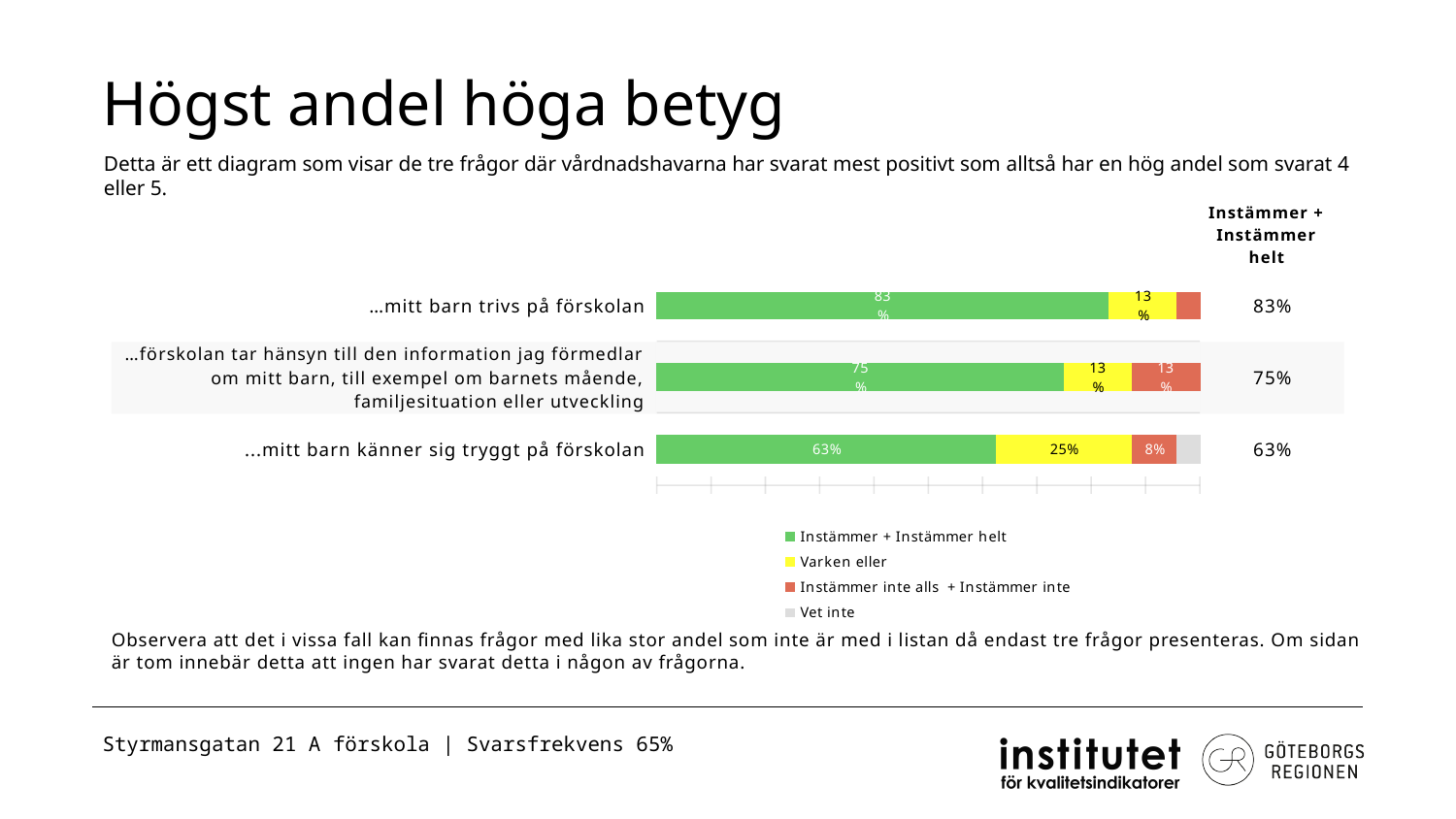
What is the 'Varken eller' value for '…mitt barn känner sig tryggt på förskolan'? 25% Which colour represents 'Vet inte' in the legend? grey What is the 'Instämmer inte alls + Instämmer inte' value for '…förskolan tar hänsyn till den information jag förmedlar om mitt barn, till exempel om barnets mående, familjesituation eller utveckling'? 13% Which has a larger 'Varken eller' share: '…mitt barn trivs på förskolan' or '…mitt barn känner sig tryggt på förskolan'? …mitt barn känner sig tryggt på förskolan What is the 'Instämmer inte alls + Instämmer inte' value for '…mitt barn känner sig tryggt på förskolan'? 8% Which question has the lowest 'Instämmer + Instämmer helt' share? …mitt barn känner sig tryggt på förskolan What is the difference in 'Instämmer + Instämmer helt' share between '…mitt barn trivs på förskolan' and '…mitt barn känner sig tryggt på förskolan'? 20% What is the 'Instämmer + Instämmer helt' value for '…mitt barn trivs på förskolan'? 83% How many questions (categories) are shown in the chart? 3 Which question has the highest 'Instämmer + Instämmer helt' share? …mitt barn trivs på förskolan What kind of chart is shown on the slide? stacked bar chart How many series does the legend list? 4